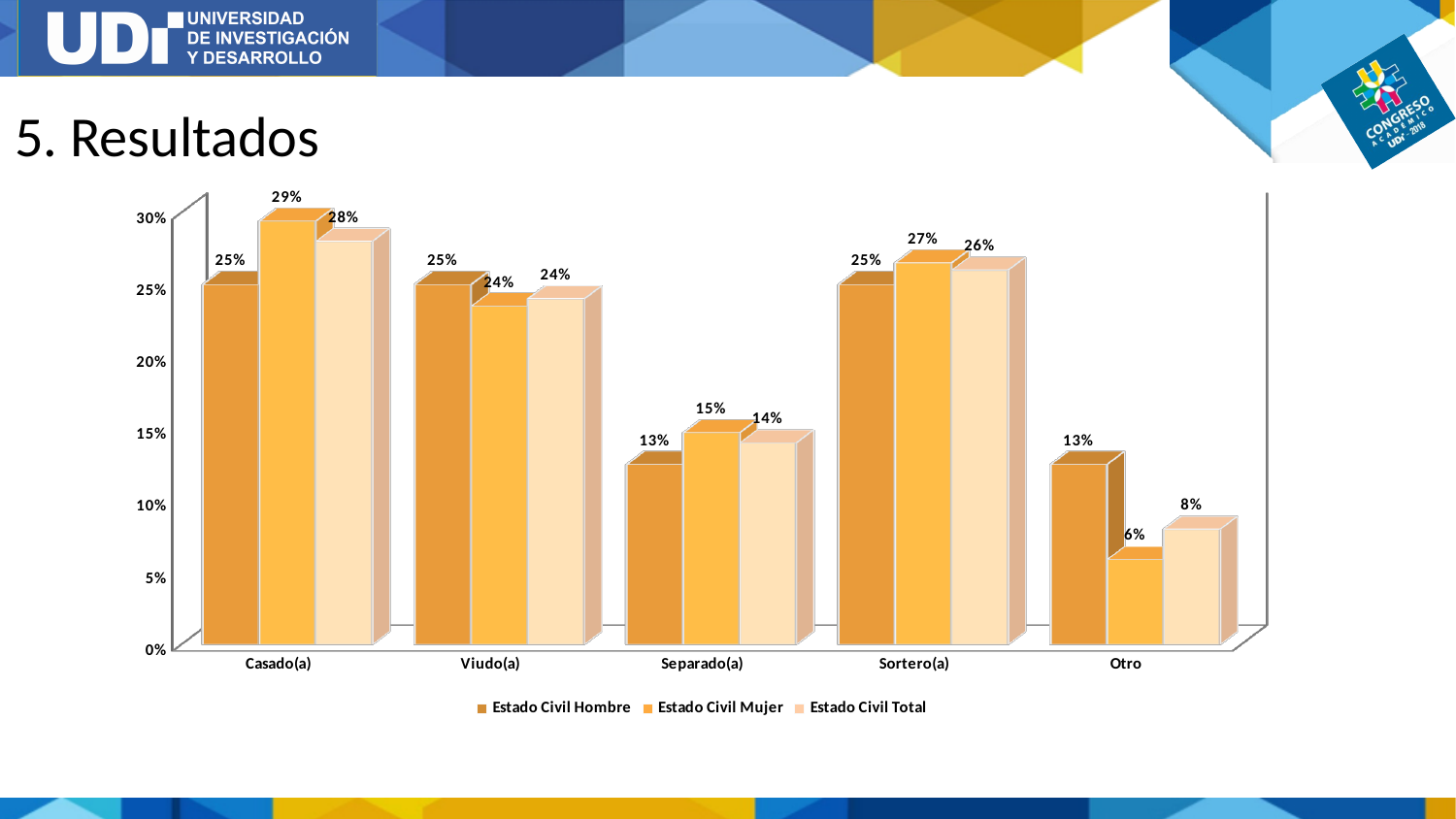
What is the value for Estado Civil Mujer in the Casado(a) category? 29% How many series does the legend list? 3 In the Separado(a) category, which is larger: Estado Civil Hombre or Estado Civil Mujer? Estado Civil Mujer How many categories are shown on the x axis? 5 What is the difference between Estado Civil Hombre and Estado Civil Mujer in the Otro category? 7% What is the title of the slide containing the chart? 5. Resultados Which category has the highest value for Estado Civil Mujer? Casado(a) What is the value for Estado Civil Total in the Sortero(a) category? 26% Which category has the lowest value for Estado Civil Total? Otro What is the value for Estado Civil Hombre in the Otro category? 13% What is the value for Estado Civil Mujer in the Otro category? 6% What kind of chart is shown on the slide? Bar chart